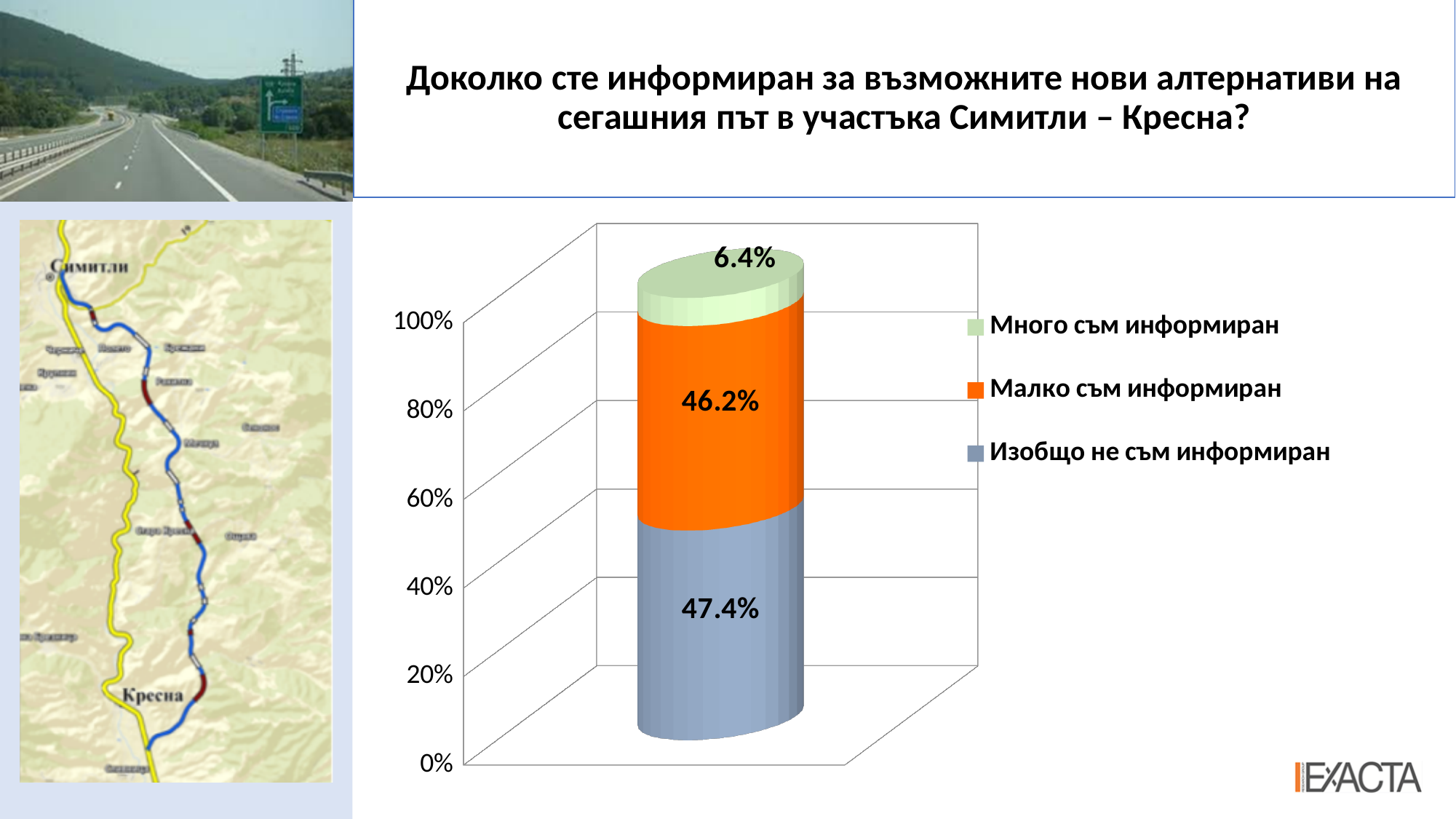
What share of respondents answered "Изобщо не съм информиран"? 47.4% Which answer option has the largest share? Изобщо не съм информиран Which colour represents "Малко съм информиран" in the legend? Orange What is the difference between the shares for "Малко съм информиран" and "Много съм информиран"? 39.8% Which is larger: the share for "Малко съм информиран" or for "Изобщо не съм информиран"? Изобщо не съм информиран What share of respondents answered "Малко съм информиран"? 46.2% What is the difference between the shares for "Изобщо не съм информиран" and "Малко съм информиран"? 1.2% What kind of chart is shown on the slide? Stacked bar chart How many series does the legend list? 3 What share of respondents answered "Много съм информиран"? 6.4% What is the total of the stacked bar? 100% Which answer option has the smallest share? Много съм информиран